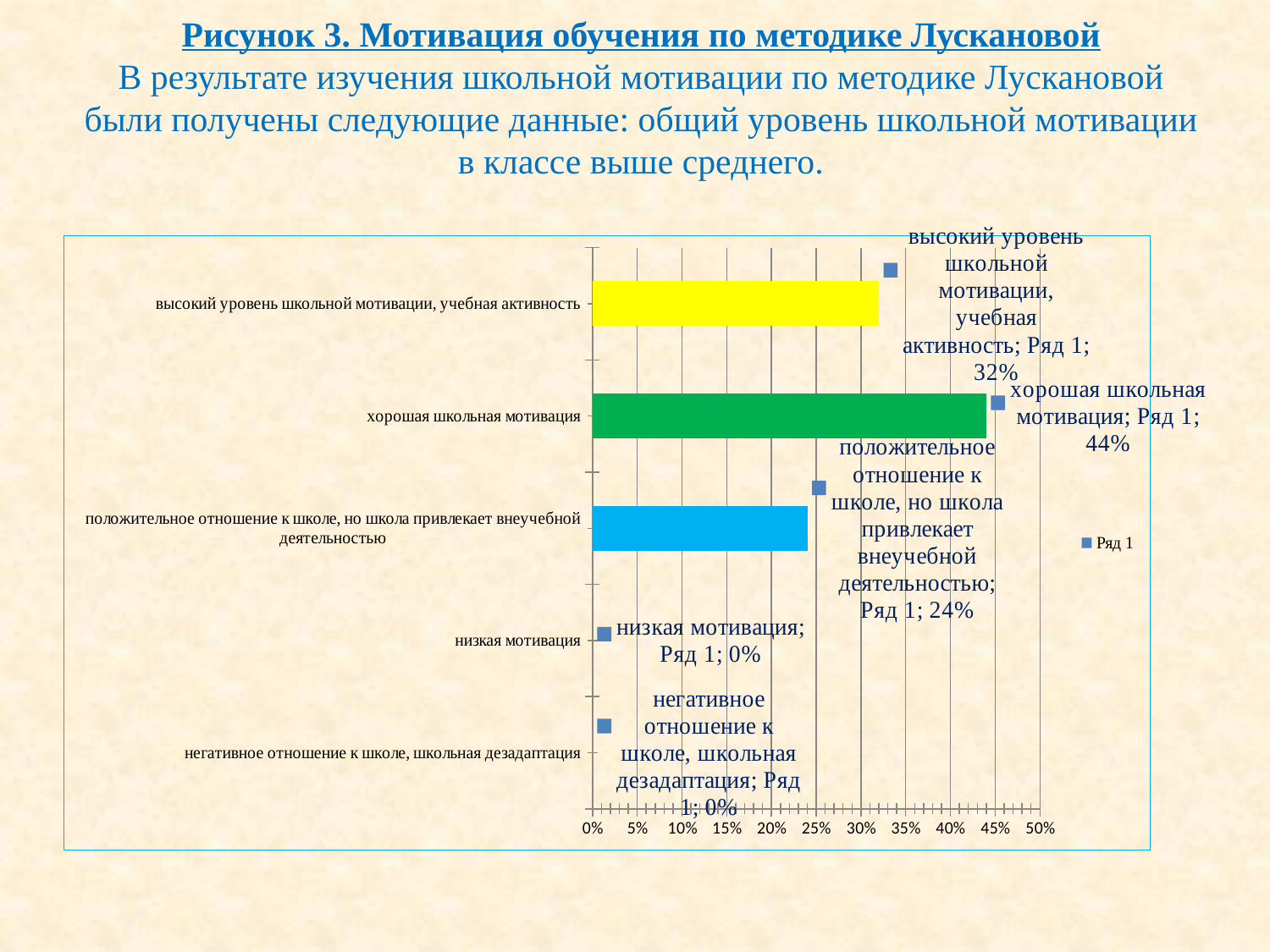
What is the value for "положительное отношение к школе, но школа привлекает внеучебной деятельностью"? 24% What is the difference between the values for "хорошая школьная мотивация" and "высокий уровень школьной мотивации, учебная активность"? 12% How many categories are shown in the chart? 5 What is the value for "низкая мотивация"? 0% What is the value for "хорошая школьная мотивация"? 44% What type of chart is shown on the slide? bar chart How many series does the legend list? 1 Which is larger: the value for "высокий уровень школьной мотивации, учебная активность" or the value for "положительное отношение к школе, но школа привлекает внеучебной деятельностью"? высокий уровень школьной мотивации, учебная активность Is the value for "хорошая школьная мотивация" greater or less than 40%? greater What is the name of the series shown in the legend? Ряд 1 What is the value for "высокий уровень школьной мотивации, учебная активность"? 32% Which category has the highest value? хорошая школьная мотивация